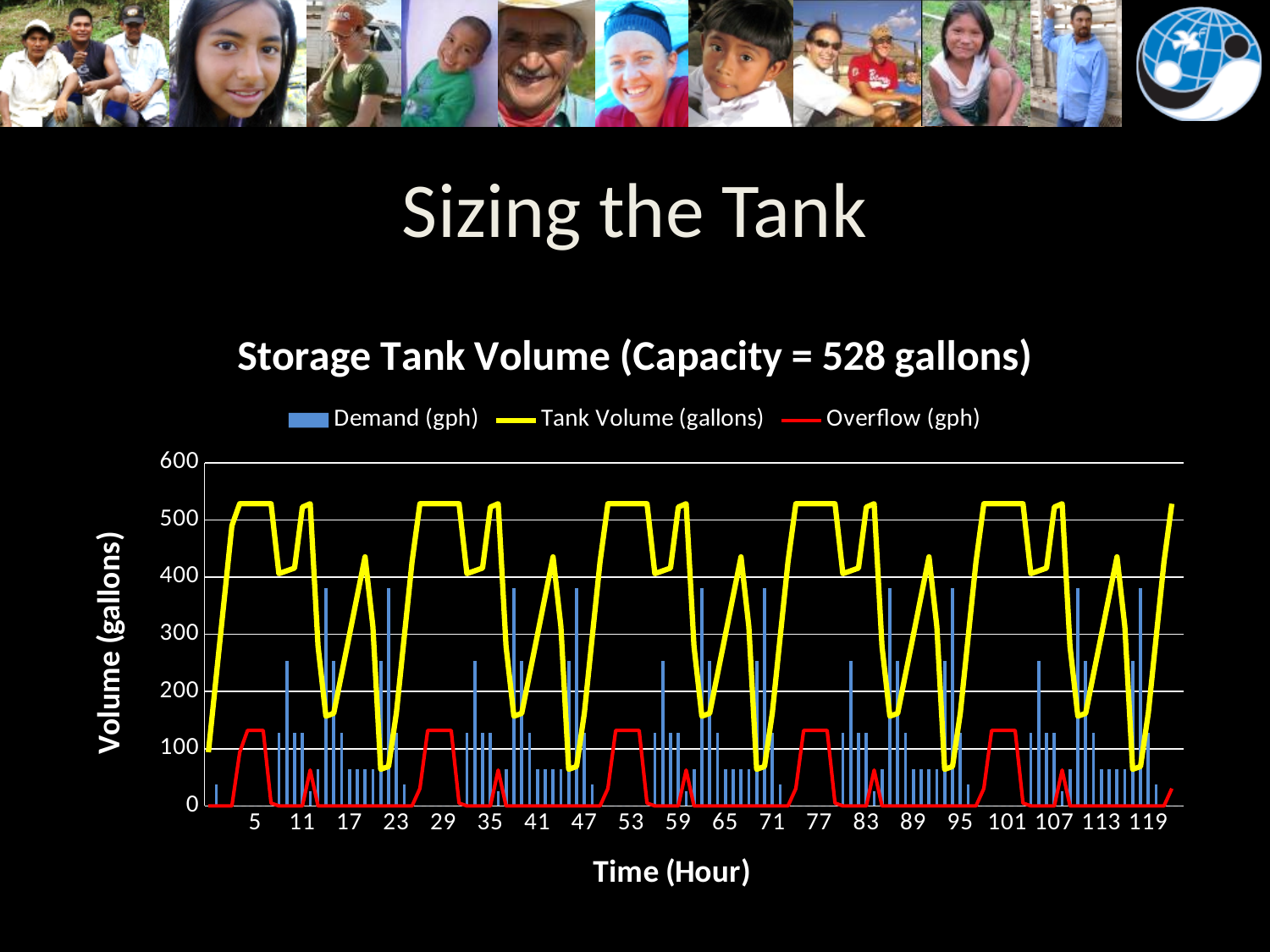
Which series is plotted as bars? Demand (gph) What kind of chart is shown on the slide? Combined bar and line chart How many series does the chart legend list? 3 What is the storage tank capacity stated in the chart title? 528 gallons Which series reaches the highest values on the chart, Demand (gph) or Tank Volume (gallons)? Tank Volume (gallons) Is the Tank Volume at hour 5 greater or less than 500? greater Is the lowest point of the Tank Volume line greater or less than 100? less What is the label of the vertical axis? Volume (gallons) Is the highest Demand (gph) bar greater or less than 400? less What is the title of the chart? Storage Tank Volume (Capacity = 528 gallons)